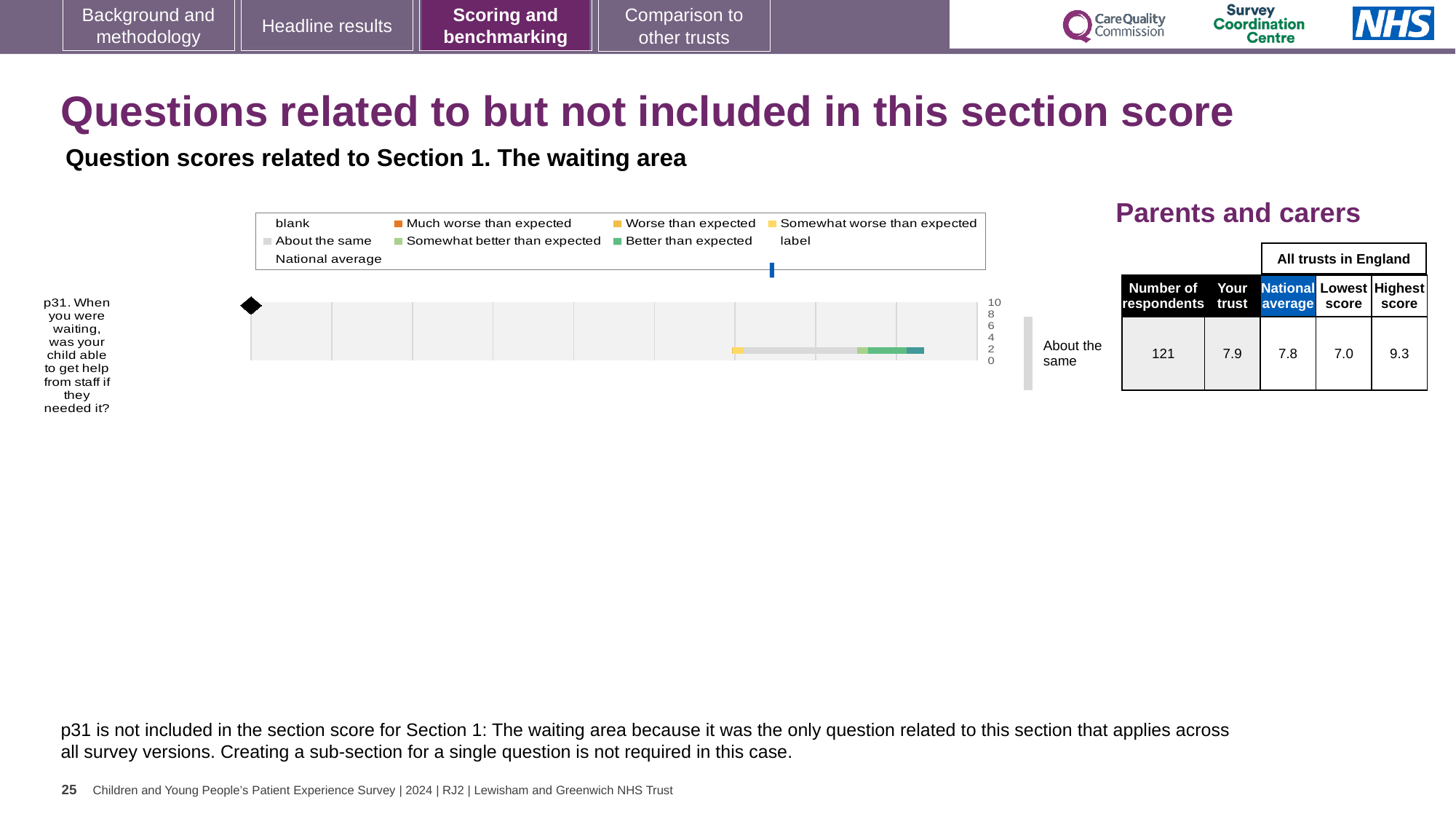
Which question number is plotted in the chart? p31 What is the difference between the Highest score and the Lowest score for p31? 2.3 How many respondents answered p31? 121 What is the National average score for p31? 7.8 What benchmark category is shown to the right of the p31 bar? About the same What is the highest value shown on the chart's numeric axis? 10 What is the Lowest score among all trusts in England for p31? 7.0 How many entries does the chart legend list? 9 How many survey questions are plotted in the chart? 1 What kind of chart is used to show the p31 benchmarking result? bar chart What is the Highest score among all trusts in England for p31? 9.3 What is the 'Your trust' score for p31 in the Parents and carers table? 7.9